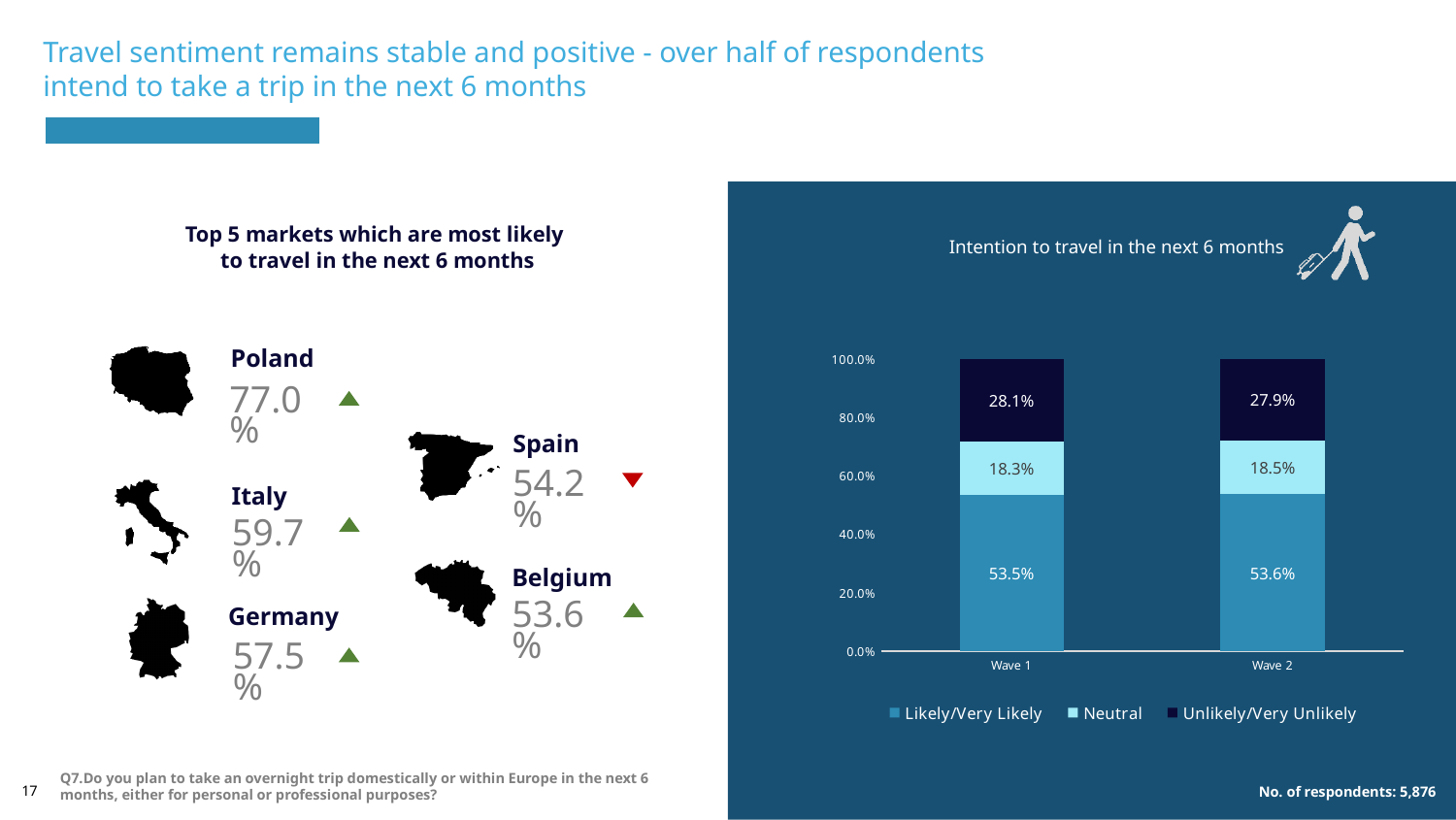
Is the Unlikely/Very Unlikely value larger in Wave 1 or Wave 2? Wave 1 Which segment is the largest in the Wave 2 bar? Likely/Very Likely What is the value for Likely/Very Likely in Wave 1? 53.5% How many bars (waves) are shown on the chart? 2 What kind of chart is shown on the slide? Stacked bar chart What is the difference between the Neutral values for Wave 2 and Wave 1? 0.2 percentage points What is the value for Unlikely/Very Unlikely in Wave 1? 28.1% What is the value for Likely/Very Likely in Wave 2? 53.6% How many series does the legend list? 3 What is the value for Neutral in Wave 2? 18.5% Which segment is the smallest in the Wave 1 bar? Neutral What is the total of the Wave 2 stacked bar? 100.0%